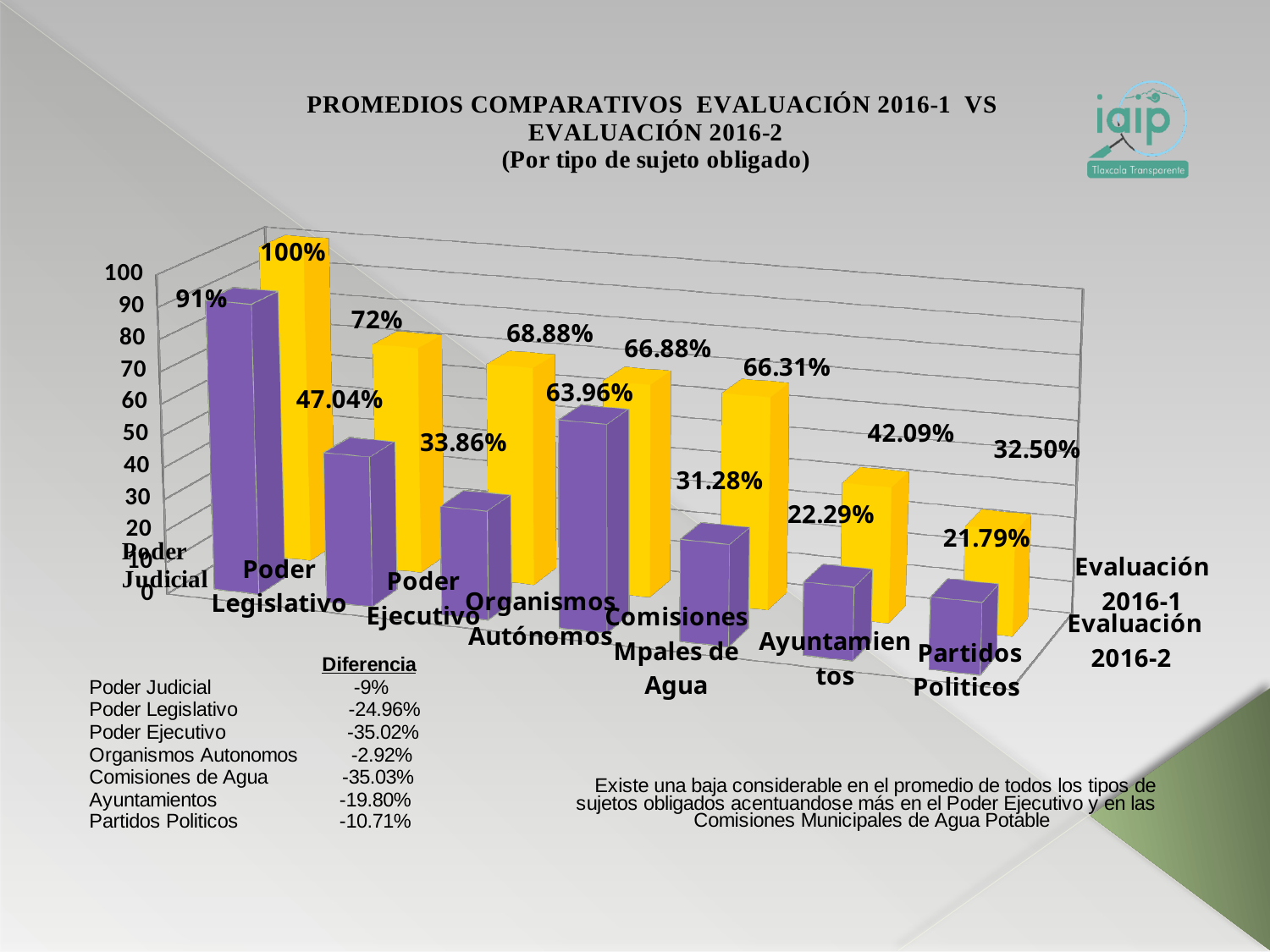
What is the Evaluación 2016-2 value for Partidos Politicos? 21.79% What kind of chart is shown on the slide? bar chart How many types of sujeto obligado (categories) are plotted on the chart? 7 Which category has the lowest Evaluación 2016-1 value? Partidos Politicos What is the Evaluación 2016-2 value for Poder Ejecutivo? 33.86% What is the Evaluación 2016-1 value for Ayuntamientos? 42.09% What is the difference between the Evaluación 2016-1 and Evaluación 2016-2 values for Poder Legislativo? 24.96% Which category has the highest Evaluación 2016-2 value? Poder Judicial What is the Evaluación 2016-1 value for Poder Judicial? 100% Do the Evaluación 2016-1 values rise or fall moving from Poder Judicial to Partidos Politicos along the x axis? fall Which is larger for Organismos Autónomos: the Evaluación 2016-1 value or the Evaluación 2016-2 value? Evaluación 2016-1